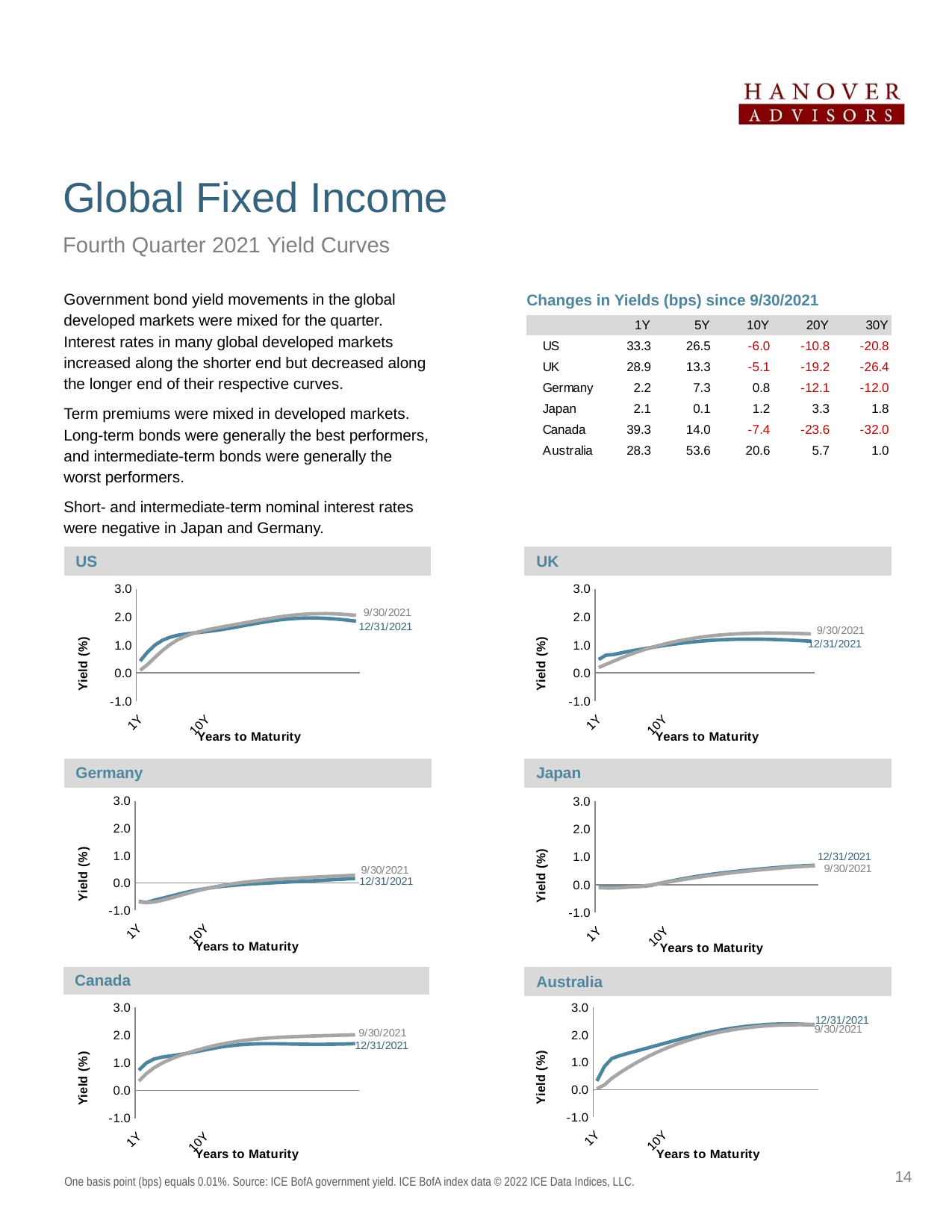
On the Japan chart, is the highest point of the 12/31/2021 line greater or less than 1.0? less What is the y-axis label on the Japan chart? Yield (%) On the US chart, is the 9/30/2021 yield at 1Y greater or less than 1.0? less How many series does the US chart show? 2 On the Germany chart, does the 12/31/2021 line rise or fall as years to maturity increase? rise What is the x-axis label on the Canada chart? Years to Maturity What kind of chart is the US chart? line chart On the Canada chart, which series is higher at the longest maturity, 9/30/2021 or 12/31/2021? 9/30/2021 On the Australia chart, does the 12/31/2021 line rise or fall as years to maturity increase? rise How many yield curve charts are on the slide? 6 On the UK chart, is the 9/30/2021 yield at the longest maturity greater or less than 2.0? less